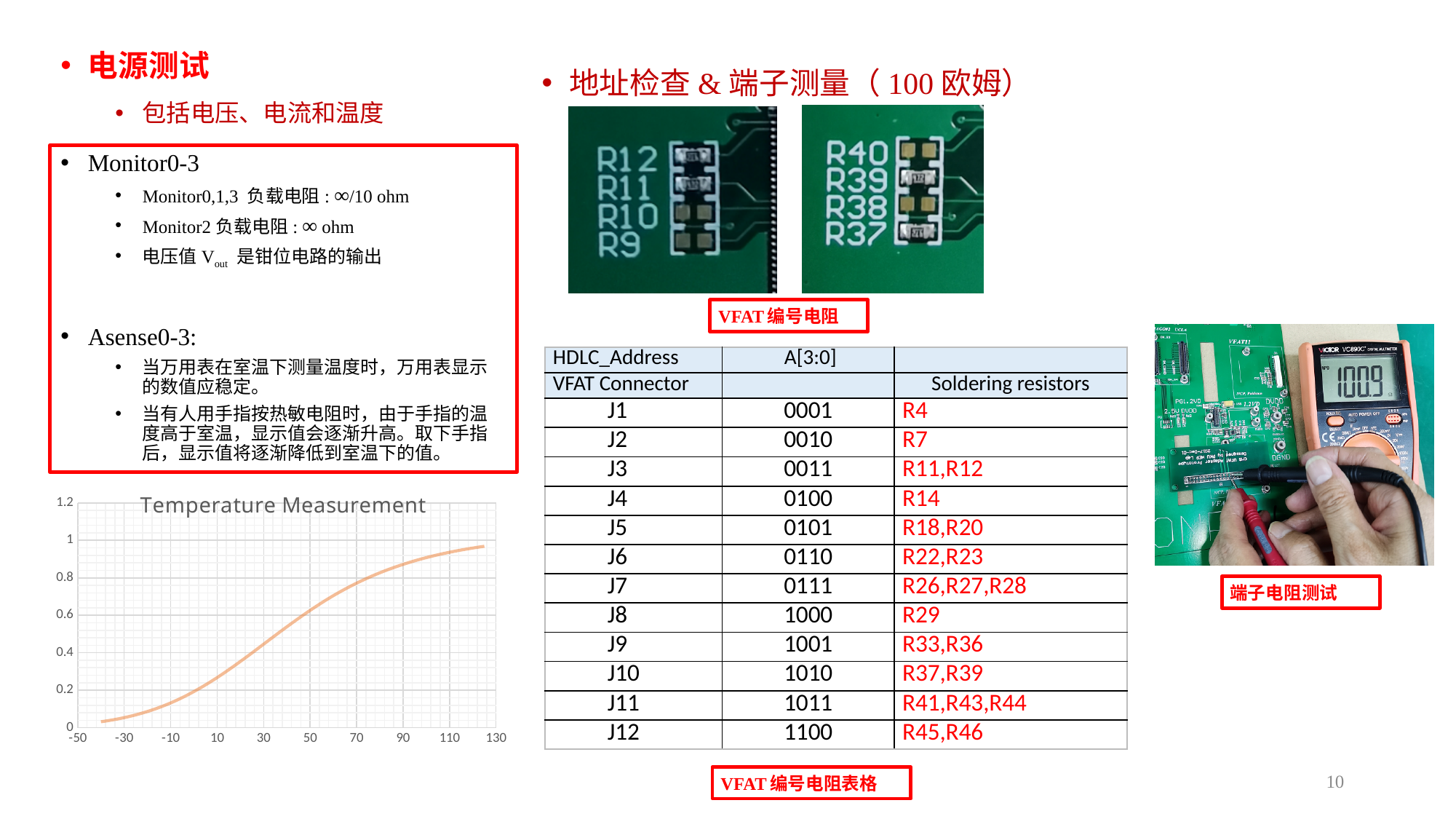
What is the title of the chart on the slide? Temperature Measurement In the Temperature Measurement chart, is the value at x = 10 greater or less than 0.4? less In the Temperature Measurement chart, is the value at x = 70 larger or smaller than the value at x = 30? larger In the Temperature Measurement chart, is the value at x = 50 greater or less than 0.4? greater What is the highest tick value shown on the y axis of the Temperature Measurement chart? 1.2 In the Temperature Measurement chart, is the value at x = 90 greater or less than 0.6? greater How many tick labels are shown on the x axis of the Temperature Measurement chart? 10 In the Temperature Measurement chart, do the values rise or fall as the x axis increases? rise What kind of chart is the Temperature Measurement chart? line chart